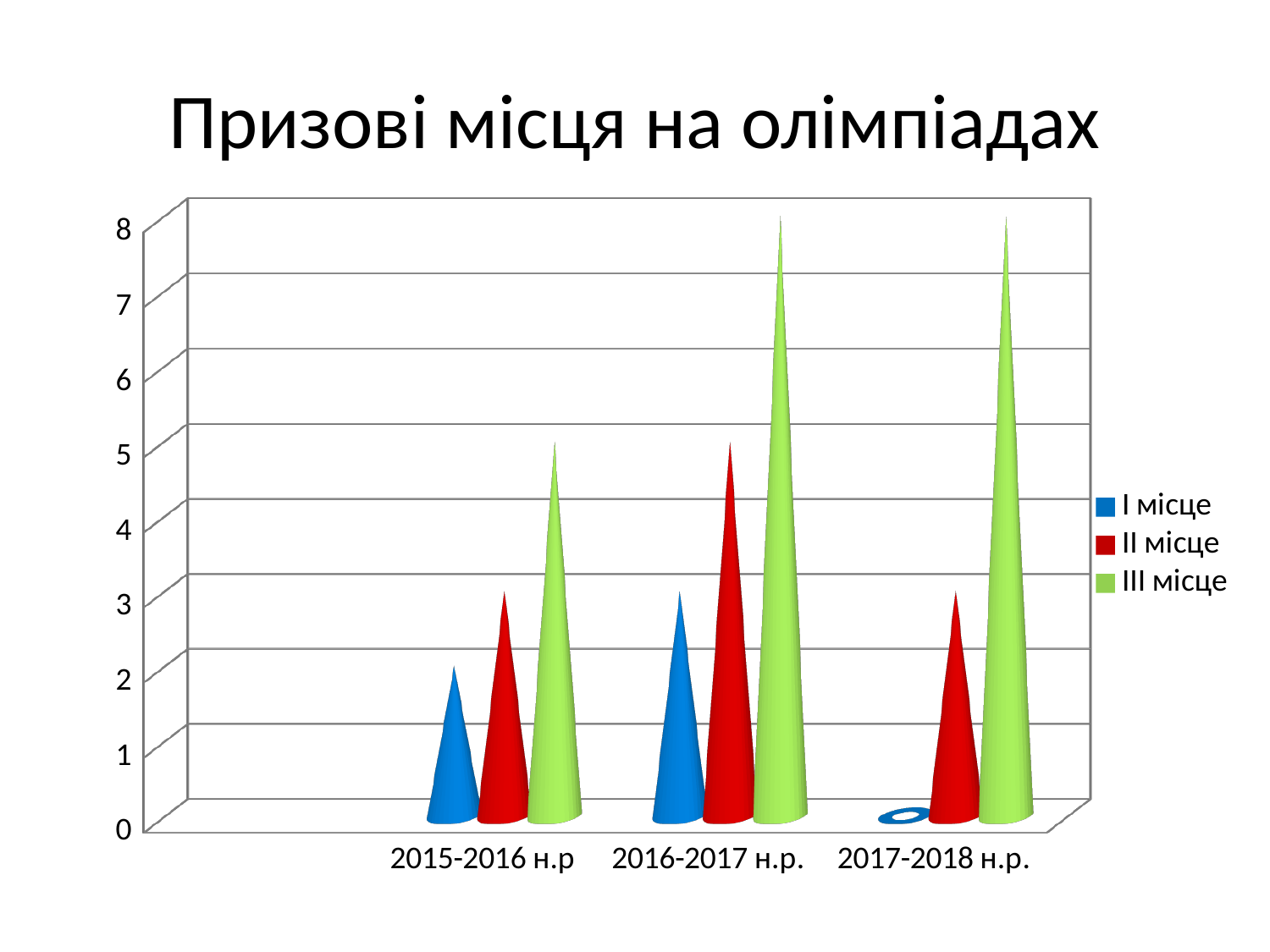
In which year is the value for I місце the lowest? 2017-2018 н.р. How many series does the legend list? 3 How many categories are shown on the x axis? 3 What is the title of the chart? Призові місця на олімпіадах Is the value for I місце in 2015-2016 н.р. greater or less than 3? less What kind of chart is shown on the slide? bar chart Is the value for II місце in 2016-2017 н.р. greater or less than 4? greater Which series is shown in green in the legend? III місце In which year is the value for II місце the highest? 2016-2017 н.р. What is the value for I місце in 2017-2018 н.р.? 0 Is the value for III місце in 2016-2017 н.р. greater or less than 6? greater Which is larger: III місце in 2015-2016 н.р or III місце in 2016-2017 н.р.? 2016-2017 н.р.